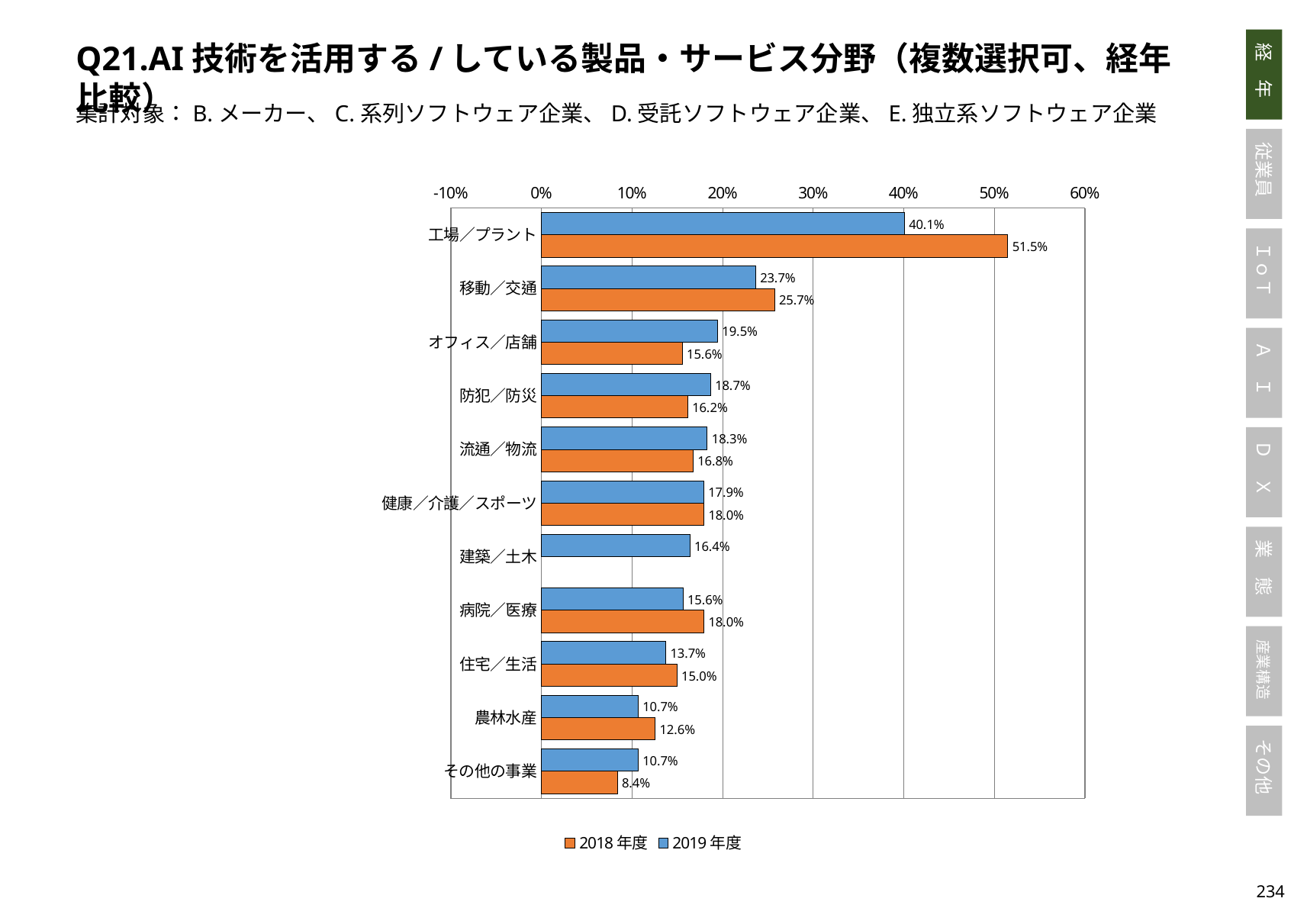
Which category has the highest 2018年度 value? 工場／プラント How many series does the legend list? 2 For オフィス／店舗, which is larger: the 2018年度 value or the 2019年度 value? 2019年度 Is the 2018年度 value for 工場／プラント greater or less than 50%? greater What is the 2018年度 value for 移動／交通? 25.7% How many categories are shown on the chart? 11 What is the difference between the 2018年度 and 2019年度 values for 工場／プラント? 11.4% What is the 2019年度 value for 工場／プラント? 40.1% Which colour represents 2019年度 in the chart? blue What kind of chart is shown on the slide? bar chart Which category has the lowest 2018年度 value? その他の事業 What is the 2019年度 value for 建築／土木? 16.4%